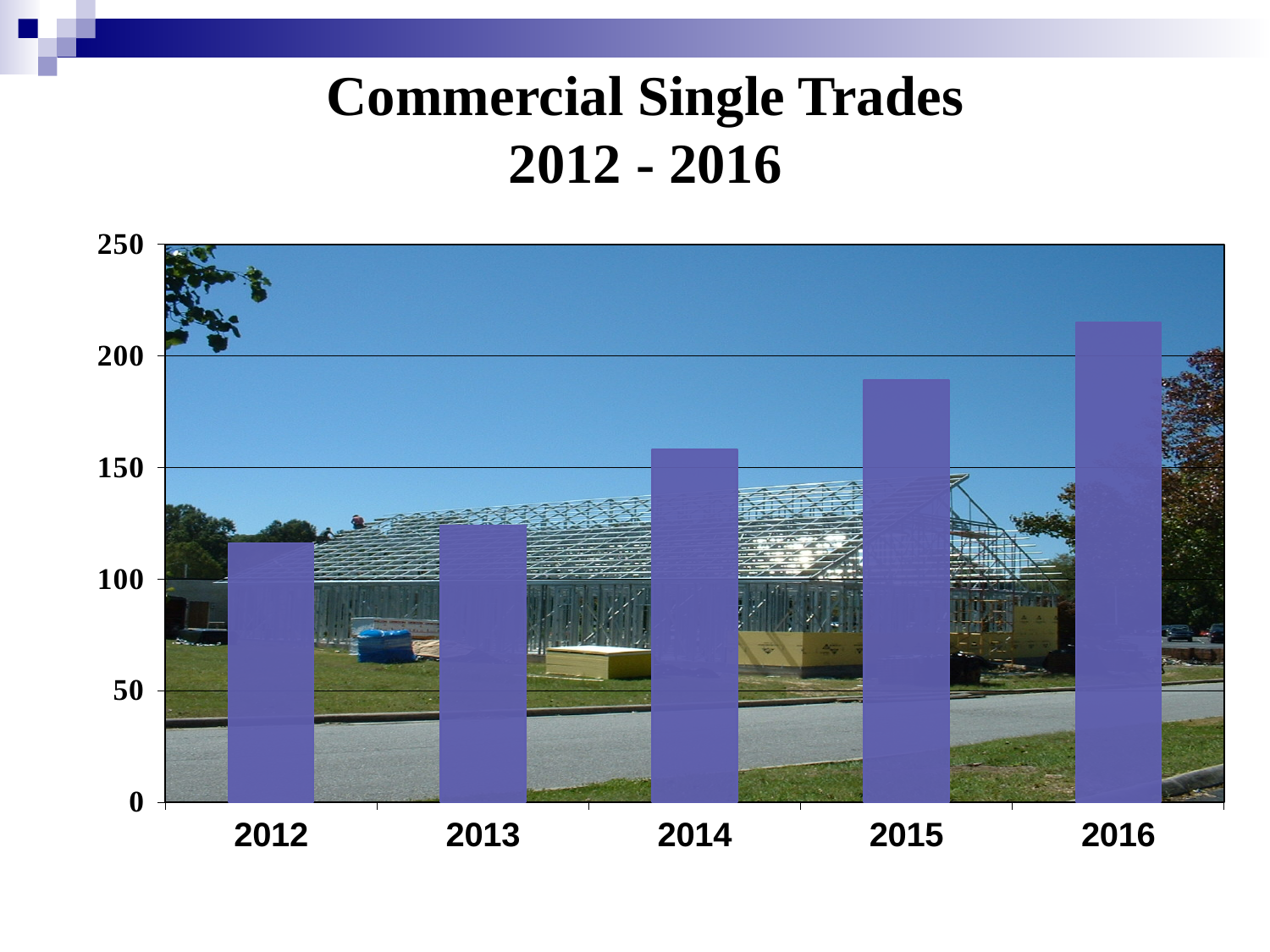
Is the value for 2016 greater or less than 200? greater Do the values rise or fall from 2012 to 2016? rise What is the title of the chart? Commercial Single Trades 2012 - 2016 Is the value for 2015 greater or less than 200? less Which year has the highest value? 2016 Which is larger, the value for 2014 or the value for 2015? 2015 Which year has the lowest value? 2012 What kind of chart is shown on the slide? bar chart How many years are plotted on the chart? 5 Is the value for 2013 greater or less than 150? less